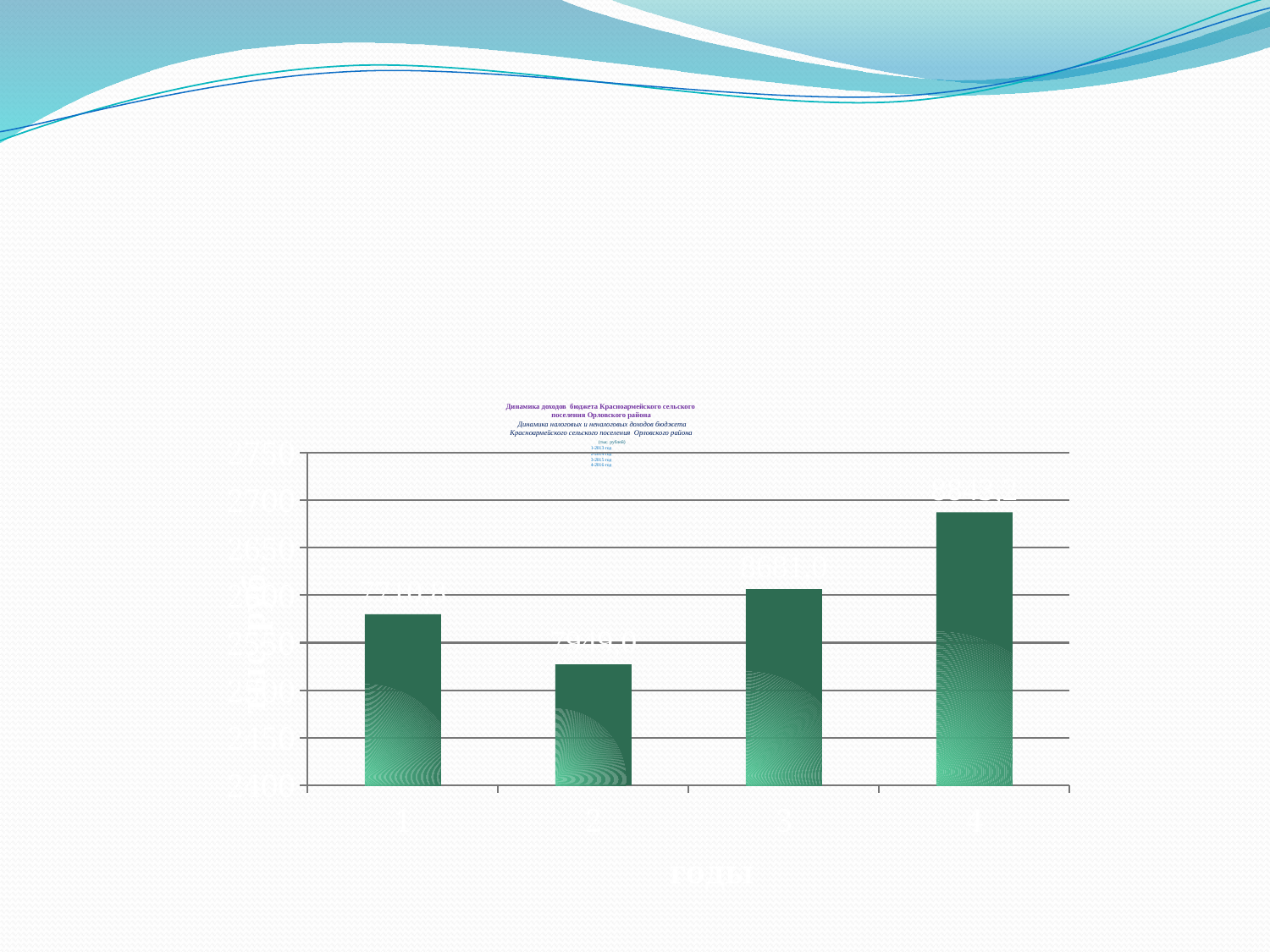
Which is larger, the value for category 1 or the value for category 2? 1 Which category has the highest bar? 4 Is the value for category 2 greater or less than 2550? less Is the value for category 2 greater or less than 2500? greater What is the label of the horizontal axis of the chart? ГОДЫ Is the value for category 4 greater or less than 2650? greater Which category has the lowest bar? 2 What kind of chart is shown on the slide? bar chart Which is larger, the value for category 1 or the value for category 3? 3 How many bars are plotted in the chart? 4